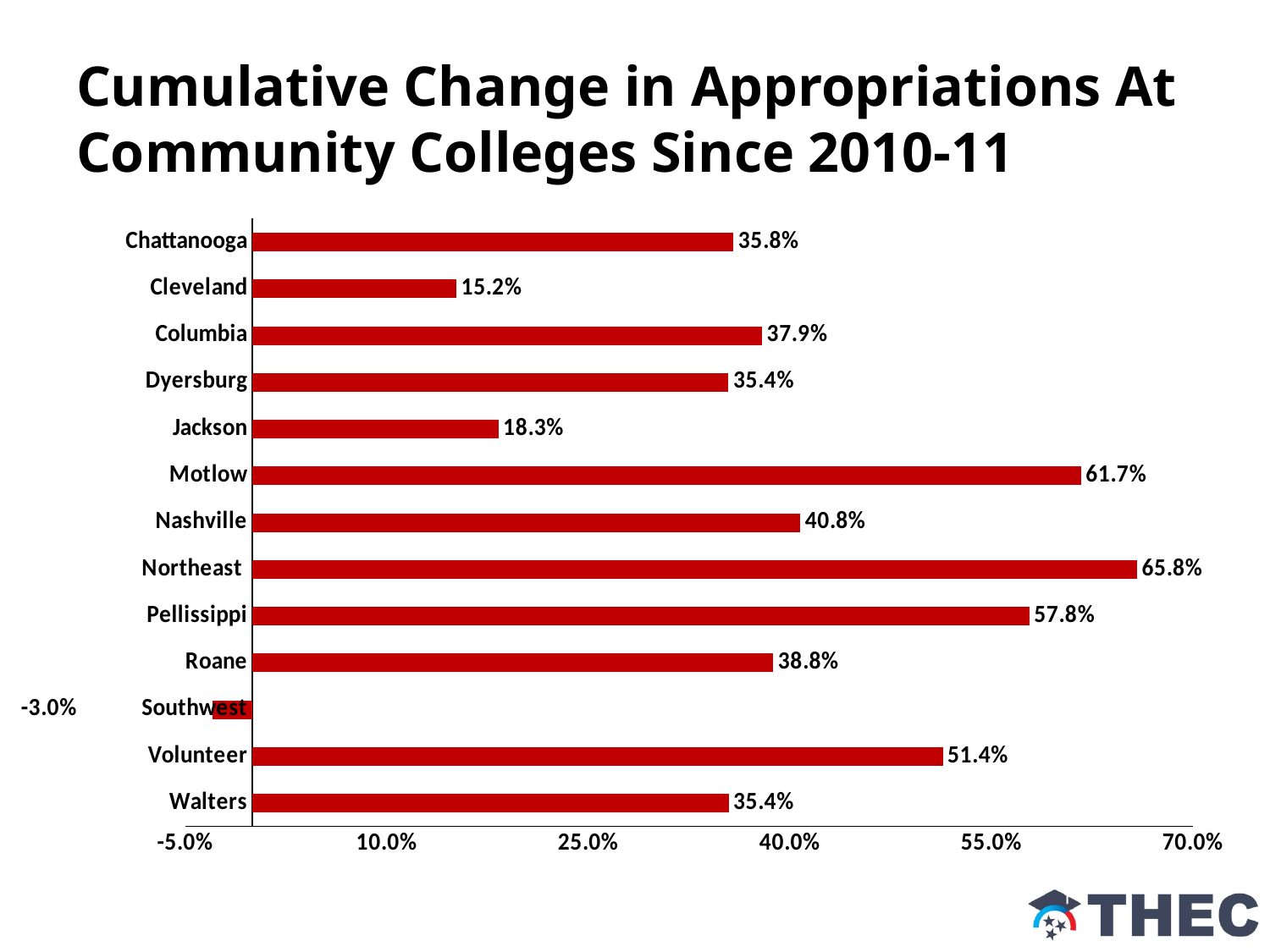
What is the difference between the values for Northeast and Pellissippi? 8.0% What kind of chart is shown on the slide? Bar chart What is the cumulative change in appropriations for Motlow? 61.7% How many community colleges are shown in the chart? 13 Which community college has the highest cumulative change in appropriations? Northeast Which community college has the lowest cumulative change in appropriations? Southwest What is the cumulative change in appropriations for Cleveland? 15.2% Which two community colleges share the same value of 35.4%? Dyersburg and Walters Is the value for Roane greater or less than 40.0%? less What is the cumulative change in appropriations for Southwest? -3.0% What is the title of the chart? Cumulative Change in Appropriations At Community Colleges Since 2010-11 Which has a larger cumulative change, Volunteer or Nashville? Volunteer